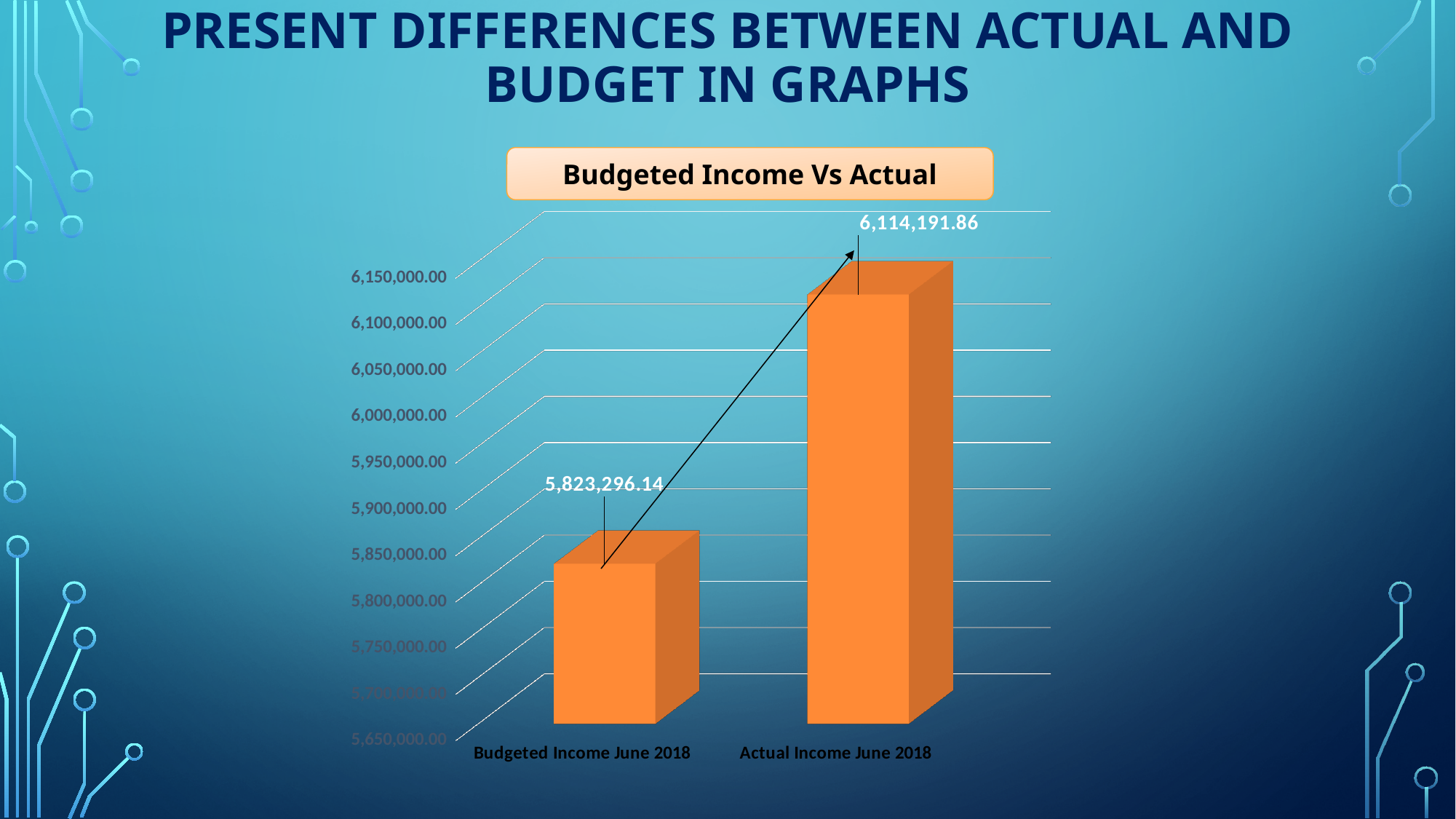
Do the values rise or fall from left to right along the x axis? rise What is the title of the chart? Budgeted Income Vs Actual Which category has the highest value? Actual Income June 2018 Is the value for Actual Income June 2018 greater or less than 6,100,000.00? greater What is the difference between Actual Income June 2018 and Budgeted Income June 2018? 290,895.72 How many categories are shown on the chart? 2 What is the value for Budgeted Income June 2018? 5,823,296.14 What kind of chart is shown on the slide? bar chart Which category has the lowest value? Budgeted Income June 2018 Is the value for Budgeted Income June 2018 greater or less than 5,850,000.00? less Which is larger, Budgeted Income June 2018 or Actual Income June 2018? Actual Income June 2018 What is the value for Actual Income June 2018? 6,114,191.86